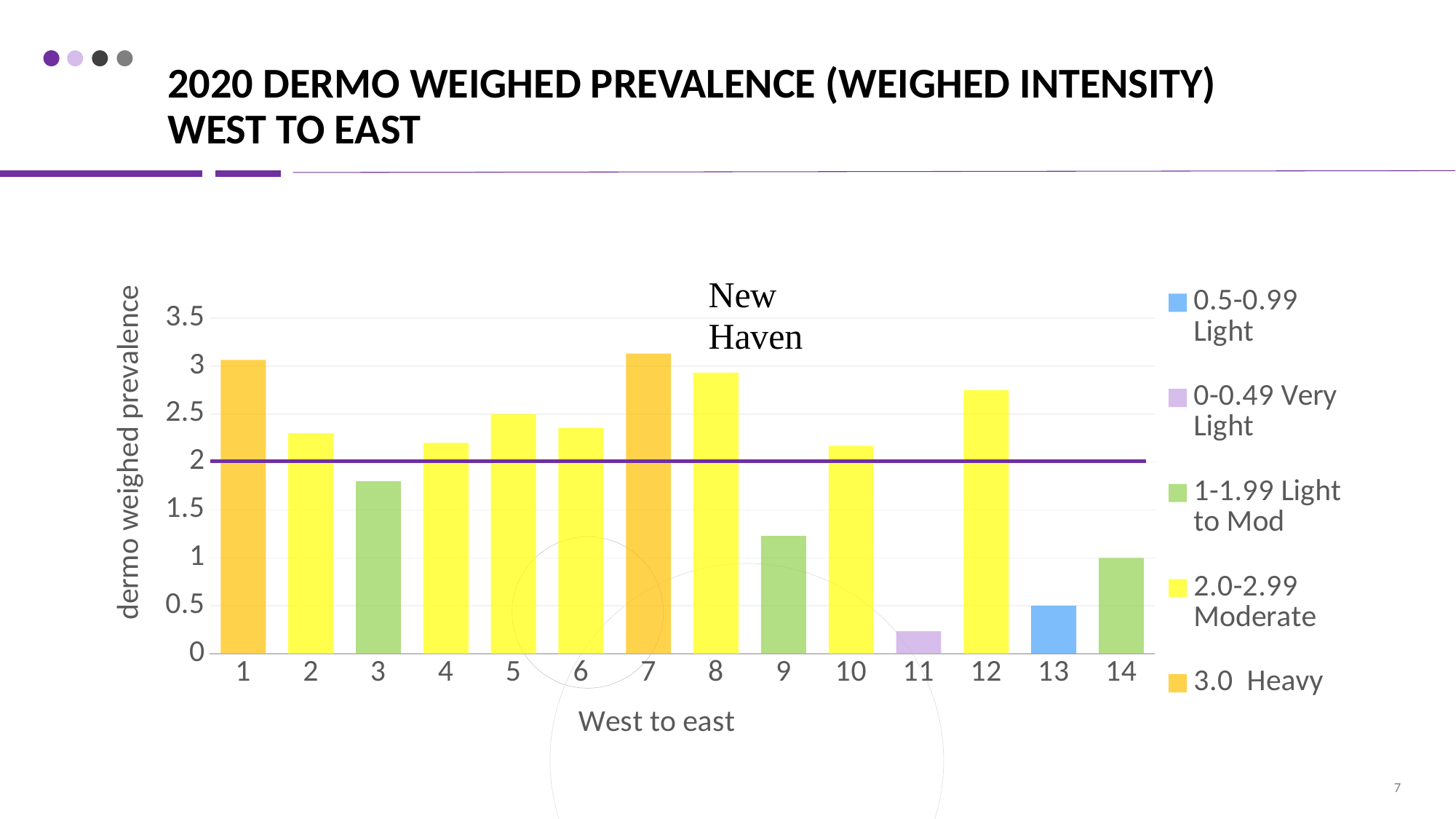
How many sites (categories) are plotted along the x axis? 14 Is the value for site 3 greater or less than 2? less Which has the higher dermo weighed prevalence, site 3 or site 9? Site 3 Which site has the lowest dermo weighed prevalence? 11 Which legend category is shown in orange? 3.0 Heavy Is the value for site 1 greater or less than 3? greater Which has the higher dermo weighed prevalence, site 8 or site 12? Site 8 How many entries does the legend list? 5 What is the title of the x axis? West to east What kind of chart is shown on the slide? Bar chart Is the value for site 11 greater or less than 0.5? less